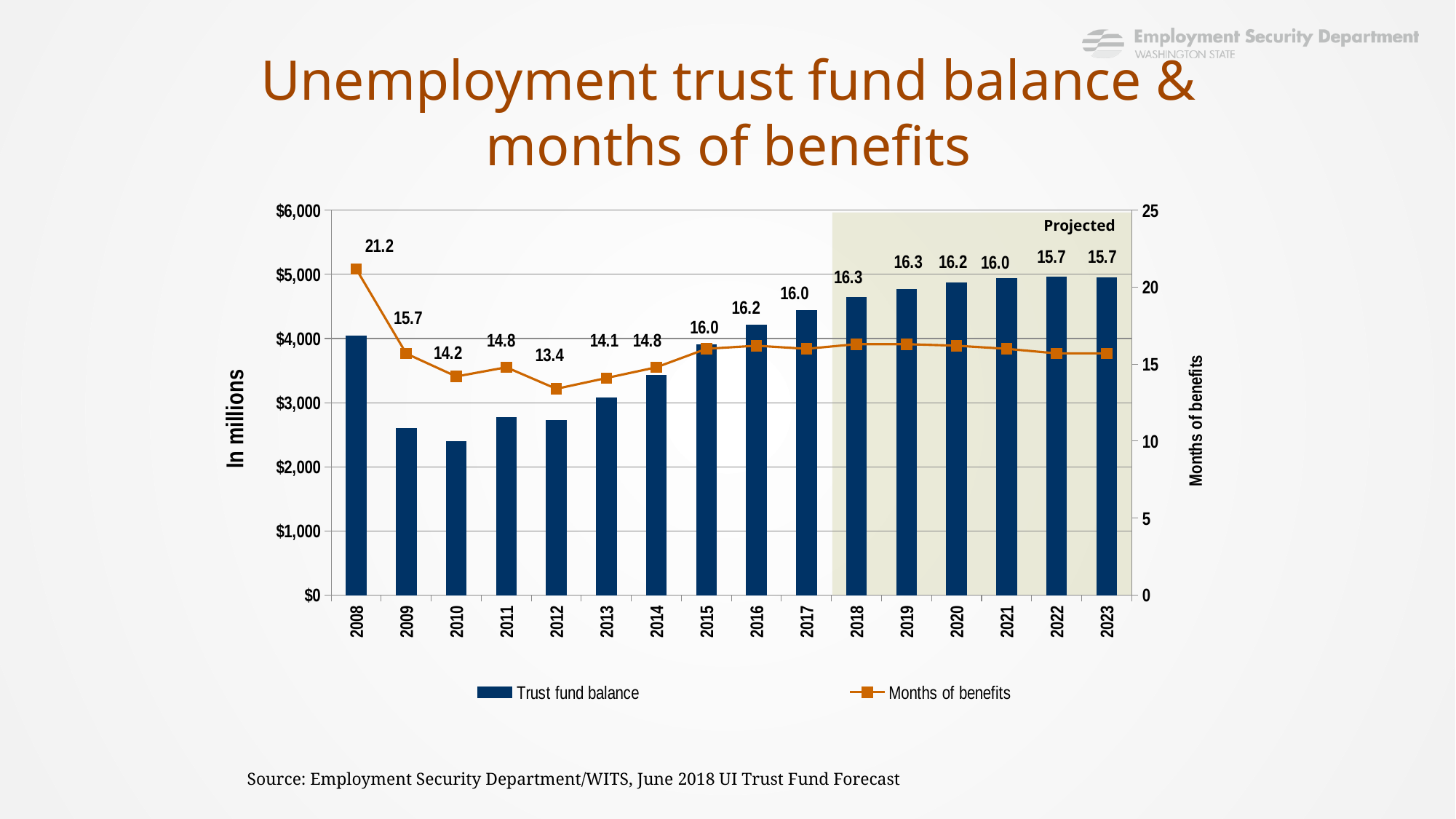
What is the difference between the months of benefits values for 2008 and 2009? 5.5 Which year has the highest months of benefits value? 2008 What is the months of benefits value for 2012? 13.4 How many series does the legend list? 2 What is the months of benefits value projected for 2023? 15.7 Which year has the lowest months of benefits value? 2012 What kind of chart is shown on the slide? Combination bar and line chart What is the months of benefits value for 2008? 21.2 Is the trust fund balance for 2010 greater or less than $3,000? less How many years are shown on the x axis of the chart? 16 Is the trust fund balance for 2017 greater or less than $4,000? greater Which year has a higher months of benefits value, 2010 or 2011? 2011